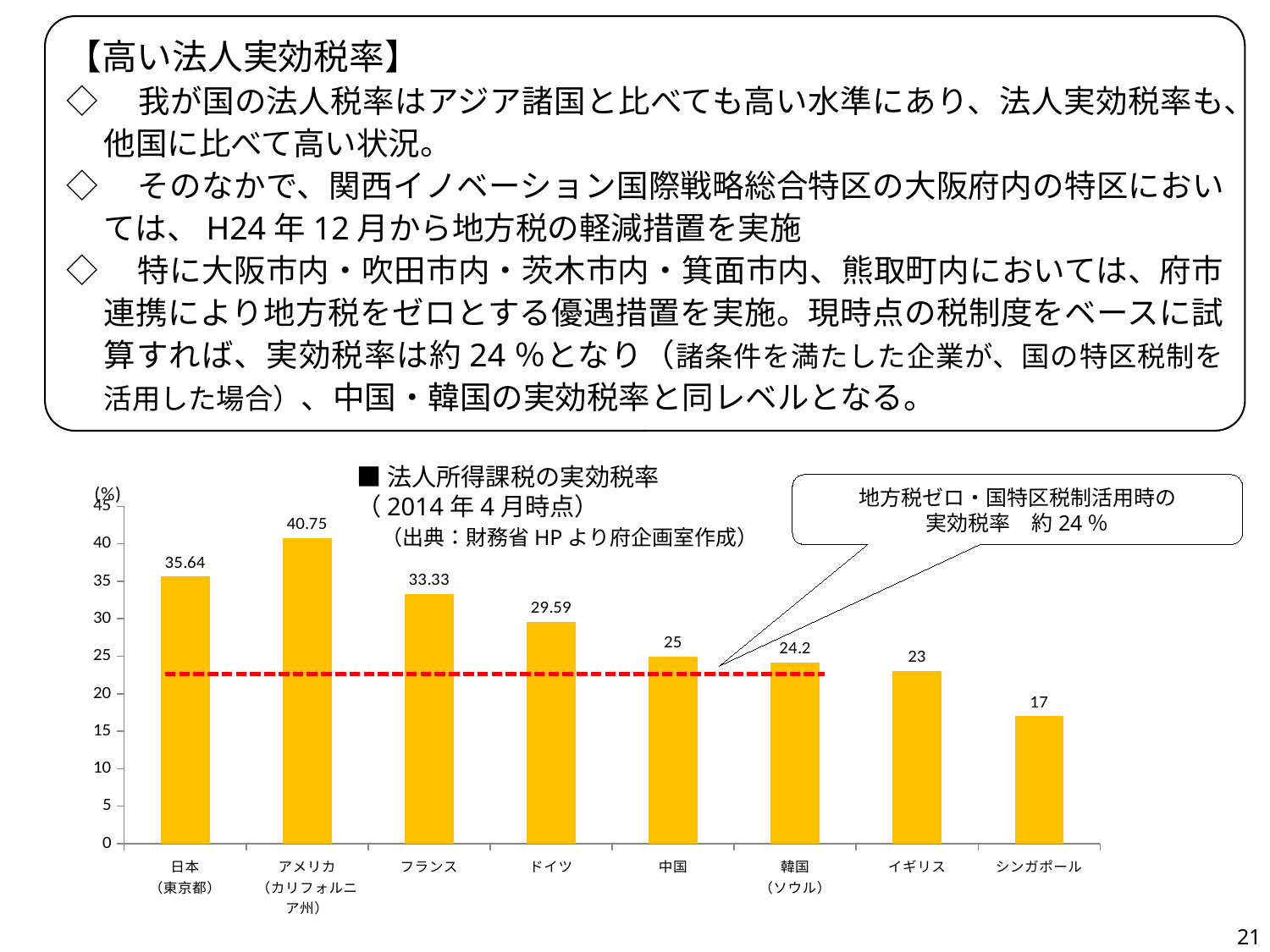
What kind of chart is shown on the slide? bar chart What is the value shown for フランス? 33.33 What is the difference between the values for 日本（東京都） and 中国? 10.64 Is the value for シンガポール greater or less than 20? less What effective tax rate does the callout box say applies when local tax is zero and the national special zone tax system is used? 約24％ What is the effective corporate tax rate shown for 日本（東京都）? 35.64 Which country has the highest effective tax rate in the chart? アメリカ（カリフォルニア州） Which has a higher value, ドイツ or イギリス? ドイツ What is the value shown for アメリカ（カリフォルニア州）? 40.75 Which country has the lowest effective tax rate in the chart? シンガポール What is the value shown for 韓国（ソウル）? 24.2 How many countries/regions are shown in the chart? 8